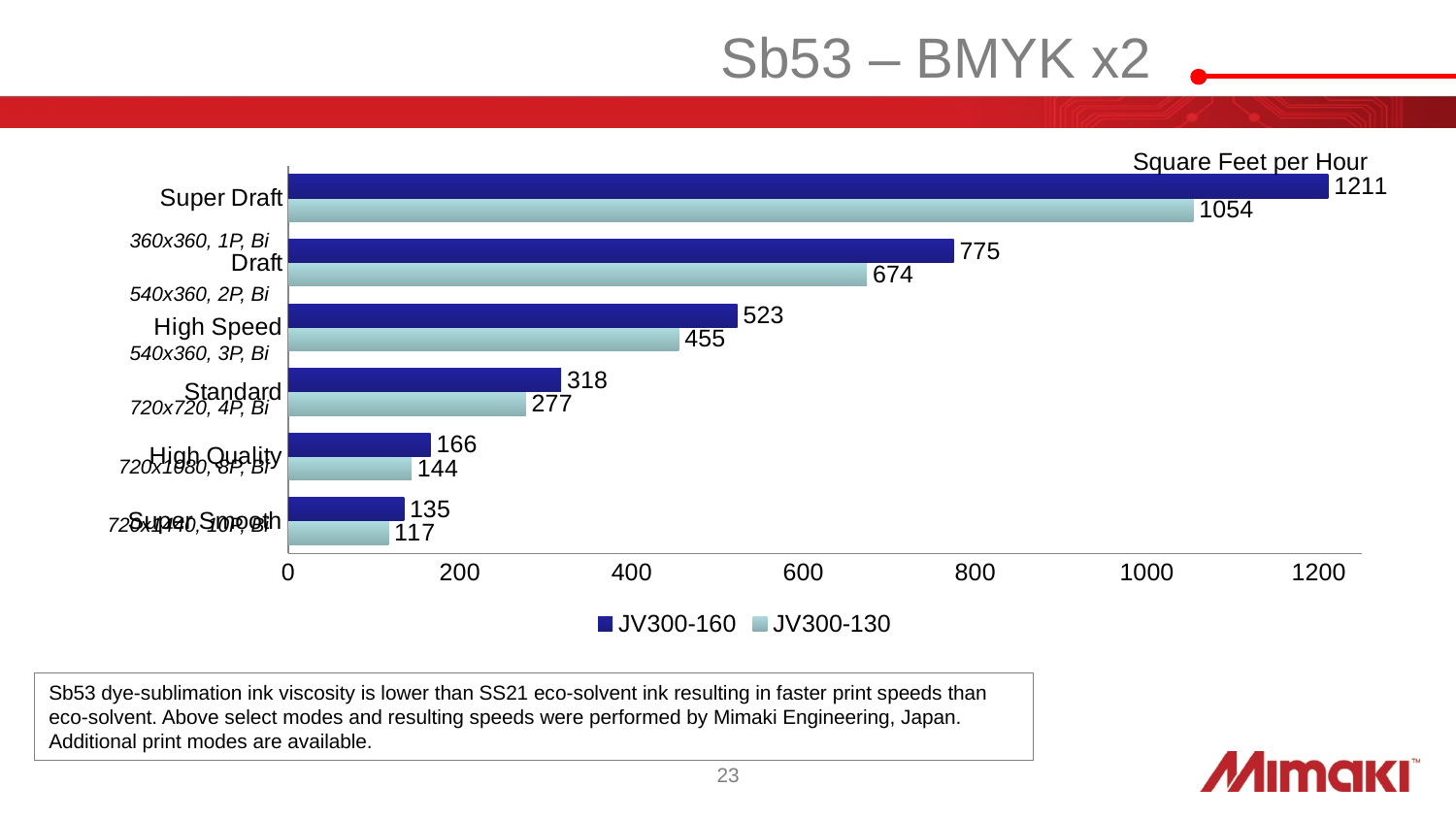
What is the Square Feet per Hour value for JV300-130 in Draft mode? 674 In High Quality mode, which printer has the larger value, JV300-160 or JV300-130? JV300-160 What is the title of the chart? Square Feet per Hour What is the Square Feet per Hour value for JV300-160 in Super Draft mode? 1211 What kind of chart is shown on the slide? Bar chart Which print mode has the lowest Square Feet per Hour for JV300-130? Super Smooth How many print modes are shown on the chart? 6 Which print mode has the highest Square Feet per Hour for JV300-160? Super Draft What is the value for JV300-160 in Standard mode? 318 What is the difference between the JV300-160 and JV300-130 values in High Speed mode? 68 How many series does the legend list? 2 What is the value for JV300-130 in Super Smooth mode? 117